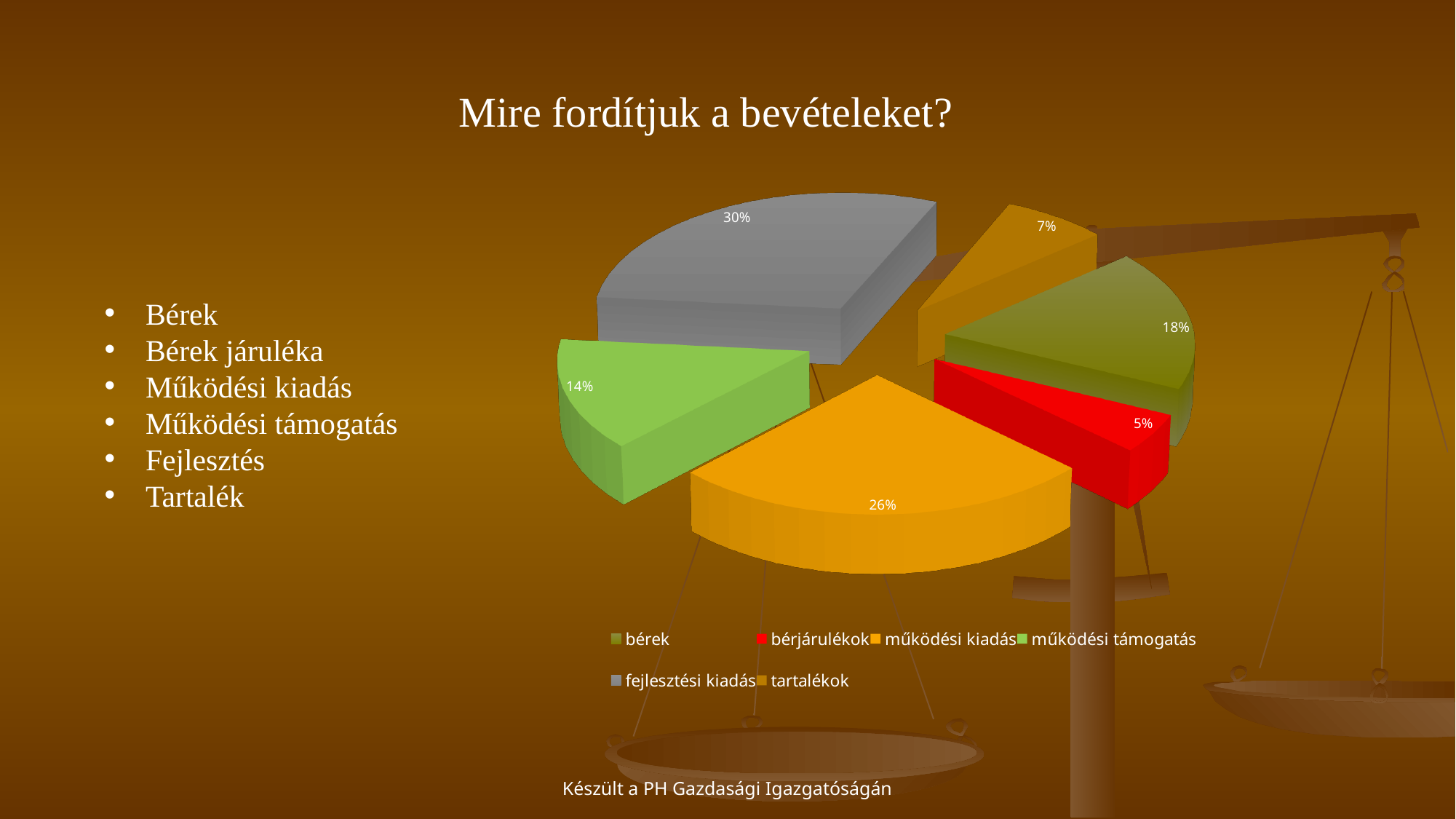
What share of the pie does működési támogatás have? 14% What share of the pie does tartalékok have? 7% How many categories does the legend list? 6 What share of the pie does bérek have? 18% Which category has the largest share of the pie? fejlesztési kiadás What share of the pie does bérjárulékok have? 5% What share of the pie does működési kiadás have? 26% What is the difference in percentage points between fejlesztési kiadás and működési kiadás? 4 What share of the pie does fejlesztési kiadás have? 30% What kind of chart is shown on the slide? pie chart Which is larger, the share for bérek or the share for működési támogatás? bérek Which category has the smallest share of the pie? bérjárulékok